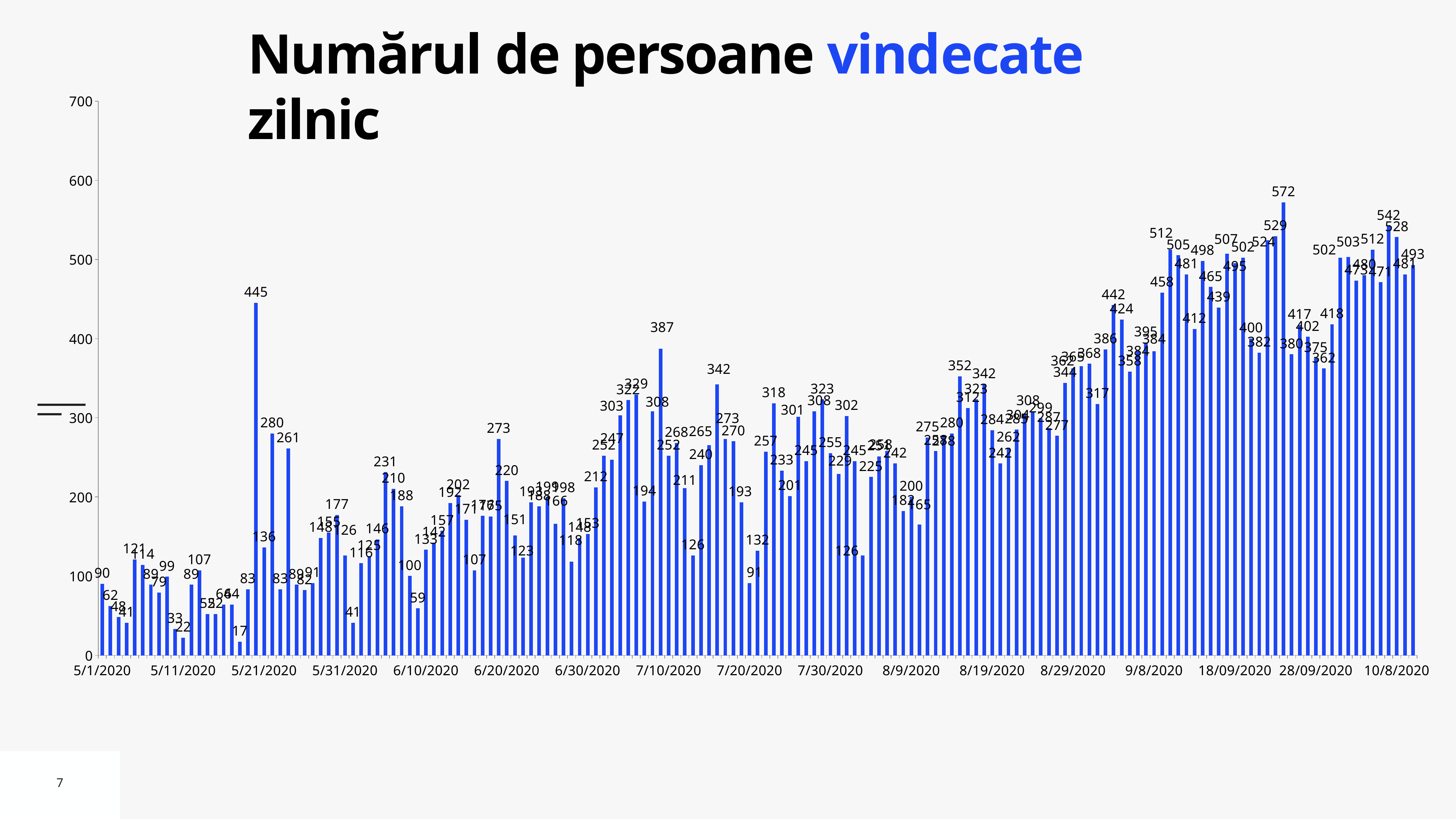
What is the lowest daily value shown in the chart? 17 Is the value for the last bar (10/8/2020) greater or less than 400? greater What is the title of the chart? Numărul de persoane vindecate zilnic What is the maximum value shown on the vertical axis? 700 What is the value for the first bar, dated 5/1/2020? 90 What is the highest daily value shown in the chart? 572 What kind of chart is shown on the slide? bar chart What is the difference between the highest value (572) and the lowest value (17) in the chart? 555 Do the values generally rise or fall from 5/1/2020 to 10/8/2020? rise Is the value for the first bar (5/1/2020) larger or smaller than the value for the last bar (10/8/2020)? smaller Is the value for the first bar (5/1/2020) greater or less than 100? less